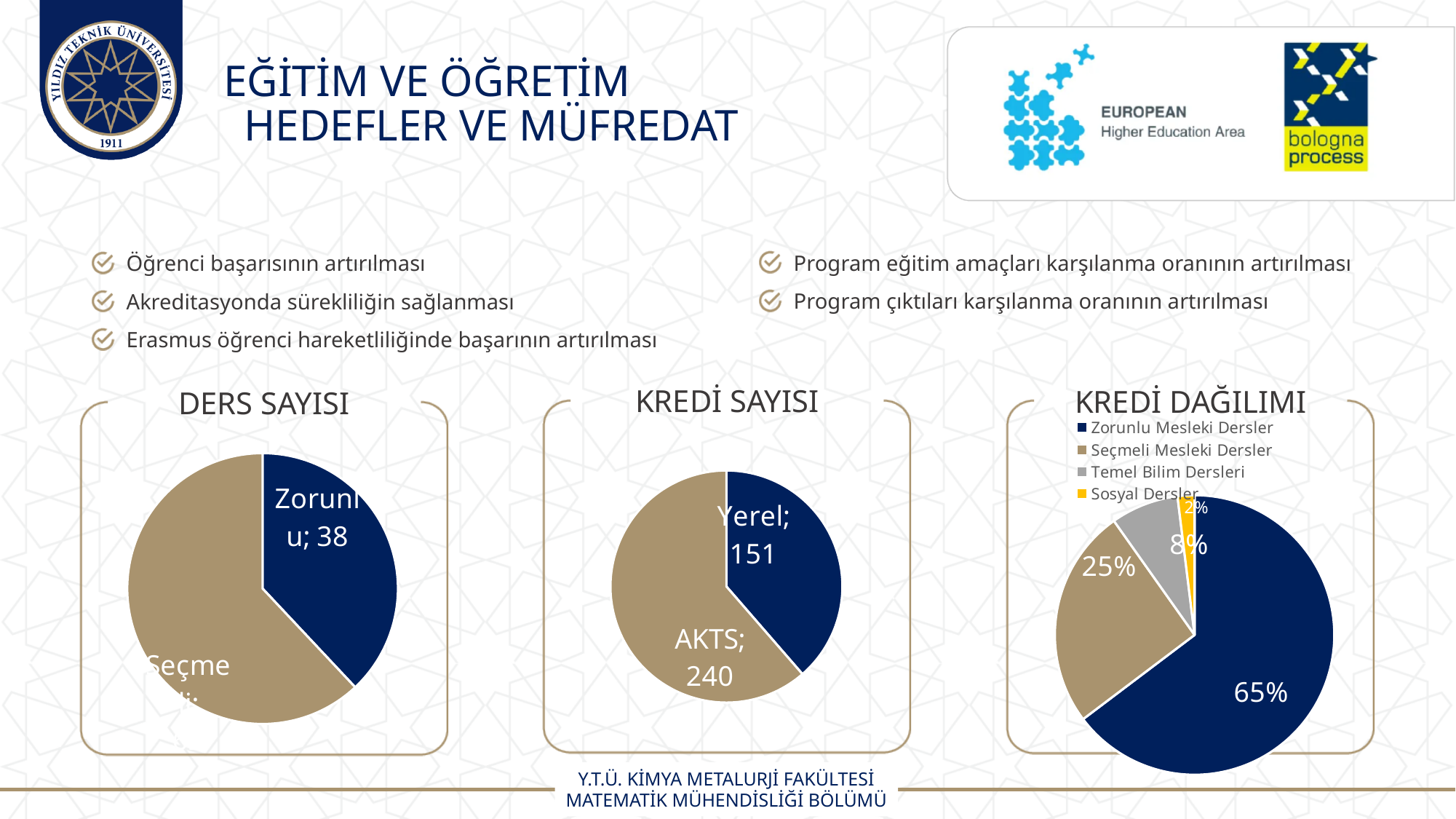
In the KREDİ DAĞILIMI chart, which category has the largest share? Zorunlu Mesleki Dersler In the KREDİ DAĞILIMI chart, what share do Temel Bilim Dersleri have? 8% In the DERS SAYISI chart, what is the value for Zorunlu? 38 In the KREDİ DAĞILIMI chart, what share do Zorunlu Mesleki Dersler have? 65% In the KREDİ DAĞILIMI chart, what share do Seçmeli Mesleki Dersler have? 25% In the DERS SAYISI chart, which slice is larger, Zorunlu or Seçmeli? Seçmeli In the KREDİ DAĞILIMI chart, which category has the smallest share? Sosyal Dersler In the KREDİ SAYISI chart, what is the value for Yerel? 151 How many categories does the legend of the KREDİ DAĞILIMI chart list? 4 In the KREDİ SAYISI chart, what is the difference between the AKTS and Yerel values? 89 In the KREDİ SAYISI chart, what is the value for AKTS? 240 What kind of chart is the KREDİ SAYISI chart? Pie chart